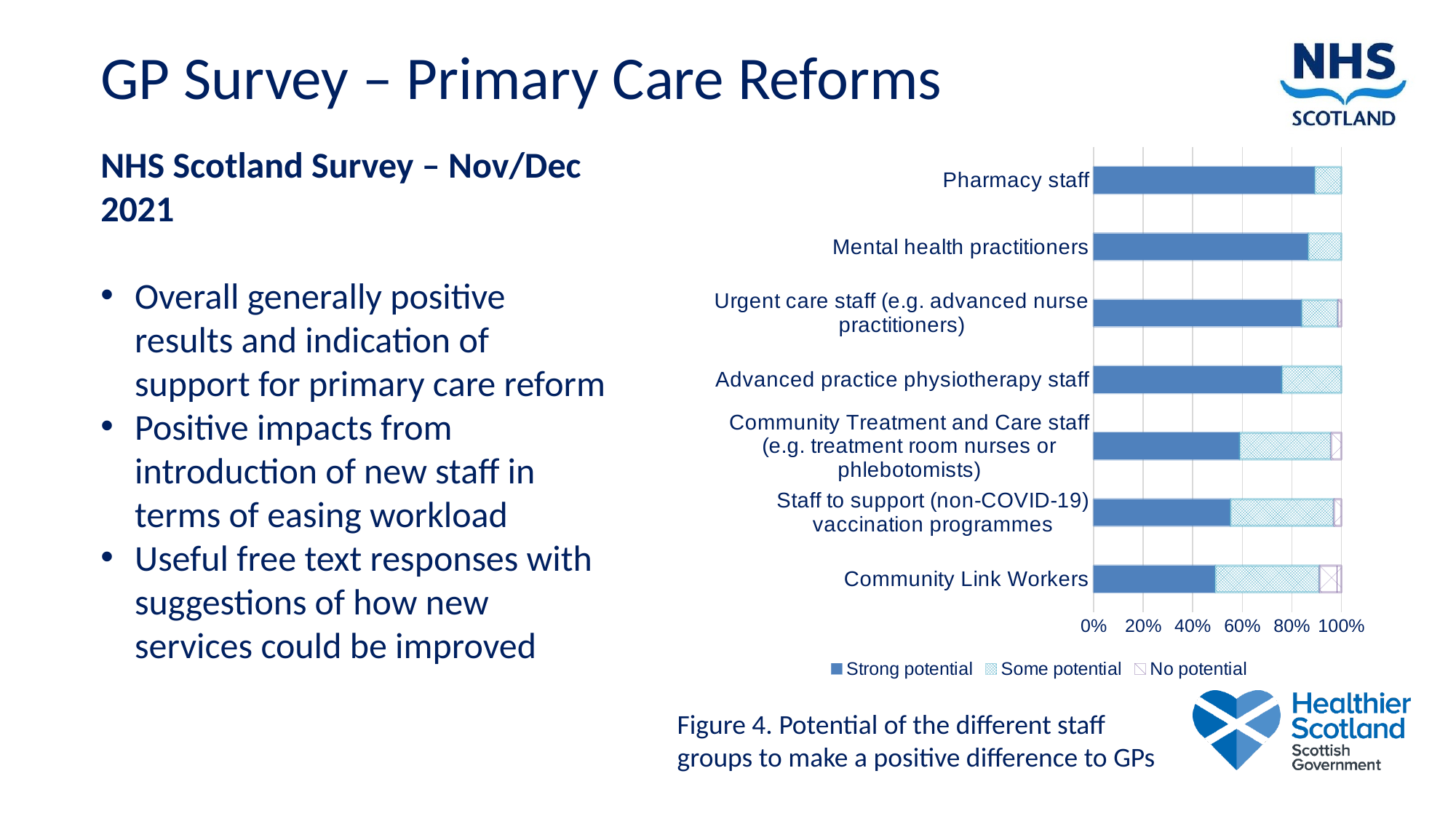
What is the figure caption given for the chart? Figure 4. Potential of the different staff groups to make a positive difference to GPs What kind of chart is shown on the slide? Bar chart Which staff group has the lowest share of 'Strong potential' responses? Community Link Workers Is the 'Strong potential' value for Pharmacy staff greater or less than 80%? greater How many series does the chart legend list? 3 Is the 'Strong potential' value for Mental health practitioners greater or less than 80%? greater What are the three series named in the chart legend? Strong potential, Some potential, No potential Is the 'Strong potential' value for Community Link Workers greater or less than 60%? less Which has a larger 'Strong potential' share: Pharmacy staff or Community Link Workers? Pharmacy staff Which staff group has the largest 'No potential' segment? Community Link Workers How many staff groups are listed on the chart? 7